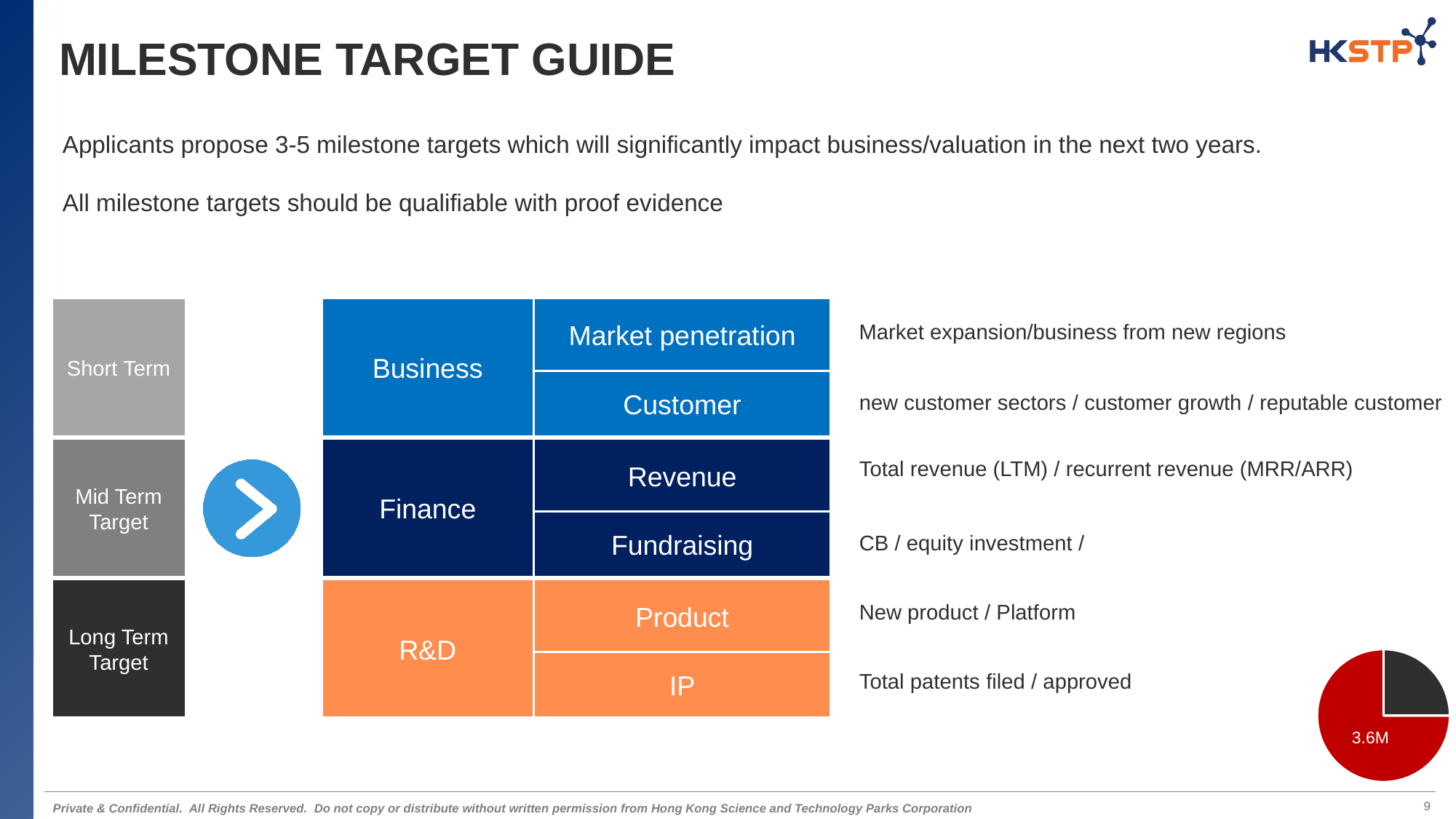
What value is printed on the red slice of the pie chart in the bottom-right corner? 3.6M In the pie chart in the bottom-right corner, what is the value label on the largest slice? 3.6M In the pie chart in the bottom-right corner, which slice is larger, the red slice or the dark grey slice? the red slice Does the pie chart in the bottom-right corner have a legend? No What kind of chart is shown in the bottom-right corner of the slide? pie chart How many slices does the pie chart in the bottom-right corner have? 2 What colour is the largest slice of the pie chart in the bottom-right corner? red